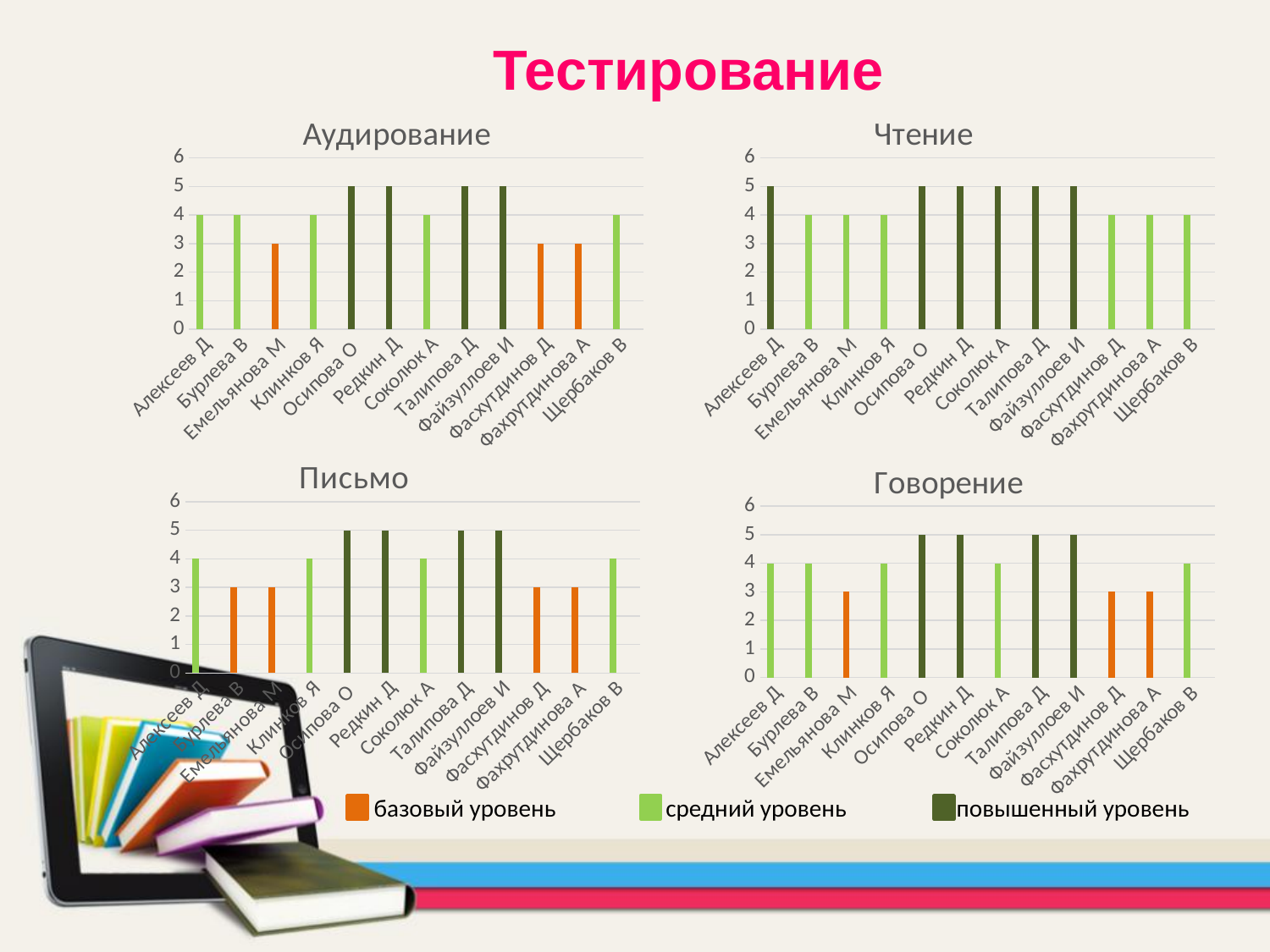
How many students are shown on the x axis of the Говорение chart? 12 In the Чтение chart, what is the value for Алексеев Д? 5 What kind of chart is the Чтение chart? bar chart In the Аудирование chart, what is the value for Емельянова М? 3 In the Чтение chart, is the value for Соколюк А greater or less than 4? greater In the Говорение chart, what is the value for Осипова О? 5 In the Письмо chart, which is larger, the value for Талипова Д or the value for Фахрутдинова А? Талипова Д According to the legend, which level do the orange bars represent? базовый уровень In the Аудирование chart, what is the difference between the values for Редкин Д and Фасхутдинов Д? 2 What is the title of the chart in the top-left of the slide? Аудирование In the Письмо chart, what is the value for Бурлева В? 3 How many entries does the legend at the bottom of the slide list? 3